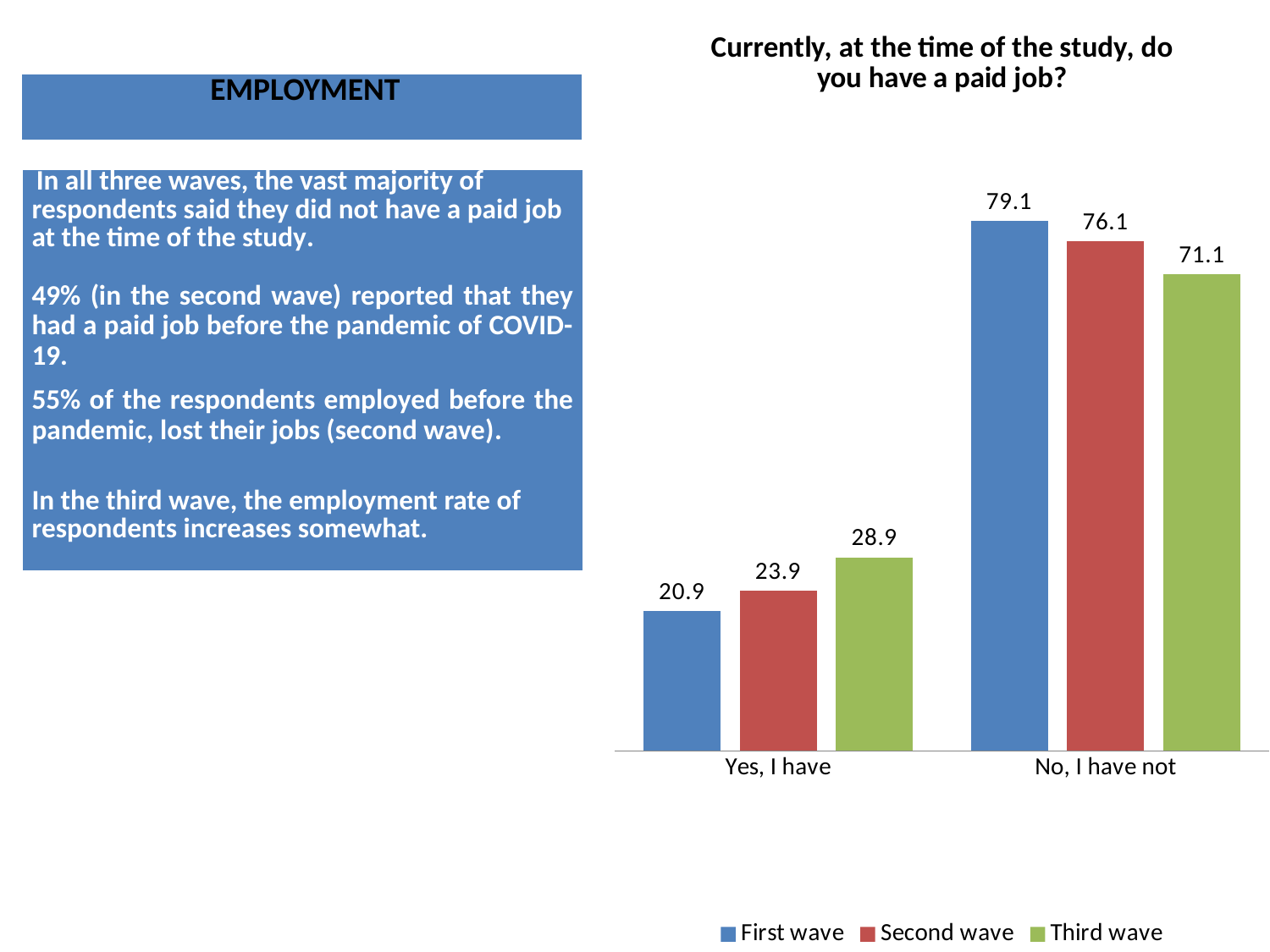
What is the value for 'Yes, I have' in the Second wave series? 23.9 How many categories are shown on the x axis? 2 Which series has the highest value for 'No, I have not'? First wave What is the value for 'No, I have not' in the Third wave series? 71.1 How many series does the legend list? 3 What kind of chart is shown on the slide? Bar chart Which series has the lowest value for 'Yes, I have'? First wave What is the difference between the First wave and Third wave values for 'No, I have not'? 8 What is the difference between the Third wave and First wave values for 'Yes, I have'? 8 What is the value for 'Yes, I have' in the First wave series? 20.9 What is the title of the chart? Currently, at the time of the study, do you have a paid job? Which is larger: the Second wave value for 'Yes, I have' or the Third wave value for 'Yes, I have'? Third wave